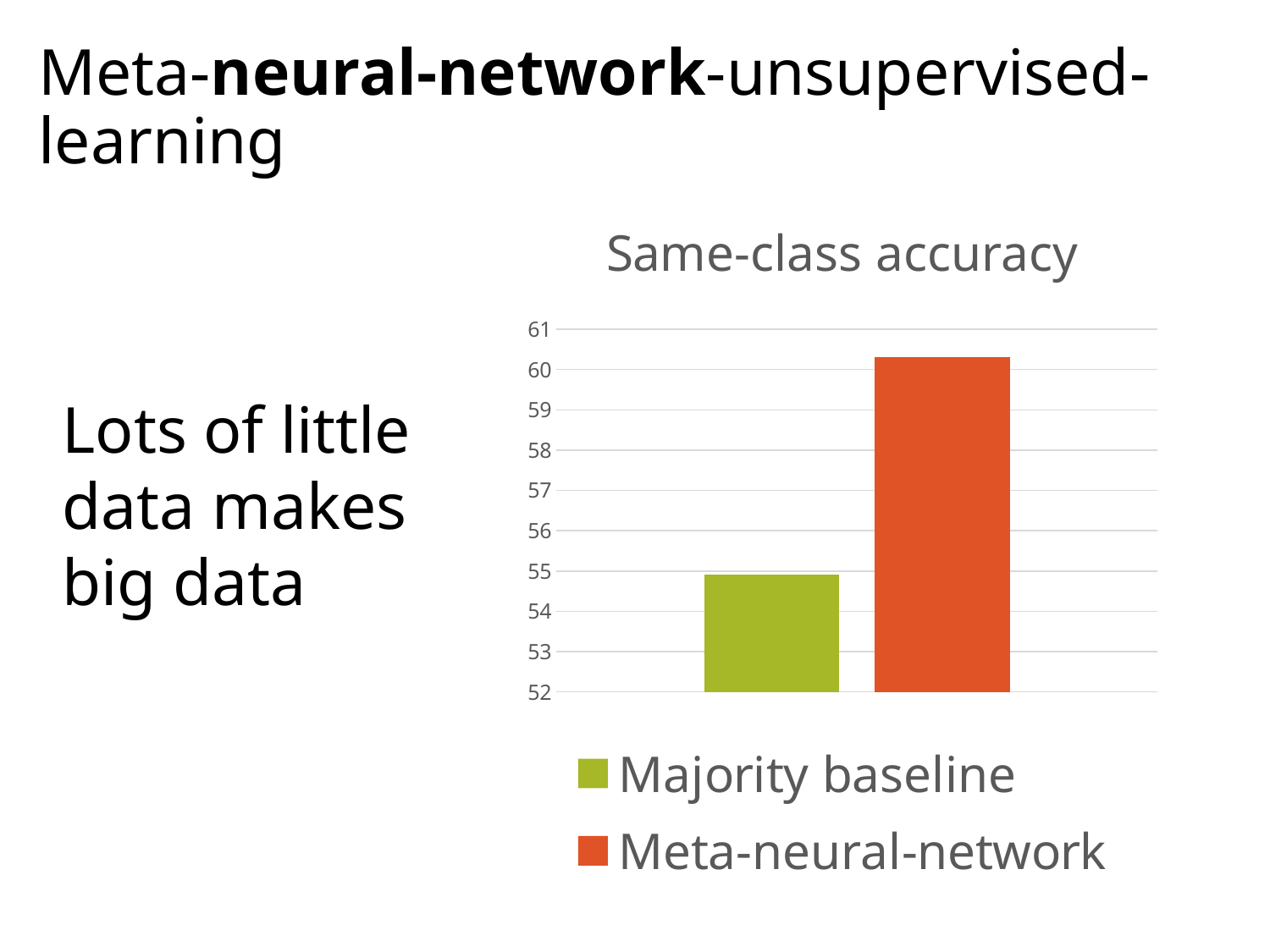
How many series does the legend list? 2 Is the value for Meta-neural-network greater or less than 61? less Is the value for Majority baseline greater or less than 54? greater Which series has the highest same-class accuracy? Meta-neural-network Is the value for Majority baseline greater or less than 56? less What kind of chart is shown on the slide? bar chart How many bars are plotted in the chart? 2 Which series has the lowest same-class accuracy? Majority baseline Which is larger, the value for Majority baseline or the value for Meta-neural-network? Meta-neural-network What is the title of the chart? Same-class accuracy What colour is the bar for Meta-neural-network? orange-red